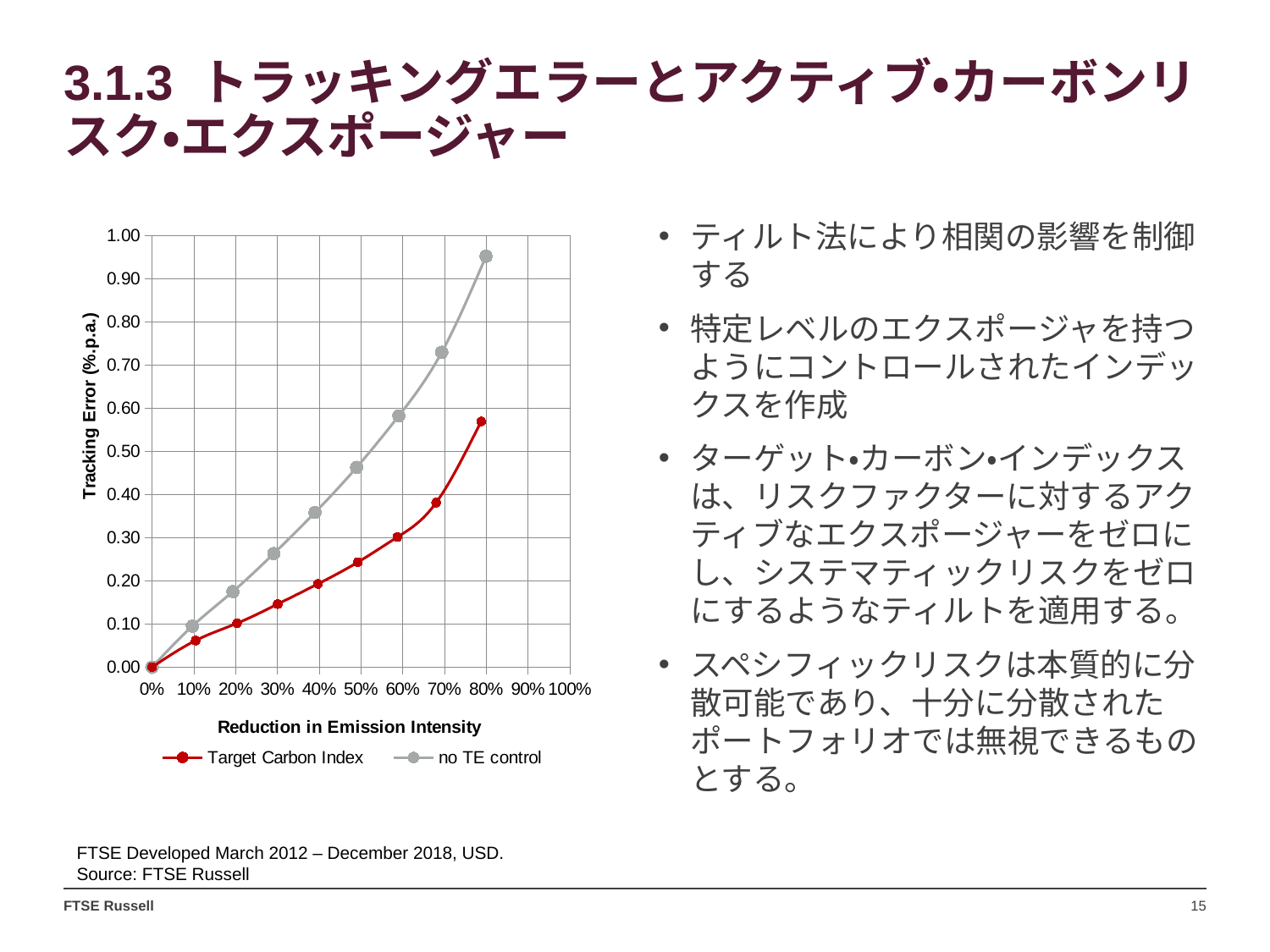
What is the title of the chart's vertical axis? Tracking Error (%.p.a.) What kind of chart is shown on the slide? line chart Is the tracking error for no TE control at an 80% reduction greater or less than 0.90? greater At an 80% reduction in emission intensity, which series has the higher tracking error, Target Carbon Index or no TE control? no TE control Is the tracking error for the Target Carbon Index at a 40% reduction greater or less than 0.30? less Does the tracking error for the Target Carbon Index rise or fall as the reduction in emission intensity increases? rise What is the tracking error for the Target Carbon Index at a 0% reduction in emission intensity? 0.00 How many series does the chart legend list? 2 What are the two series named in the chart legend? Target Carbon Index and no TE control Which series reaches the highest tracking error on the chart? no TE control Is the tracking error for the Target Carbon Index at an 80% reduction greater or less than 0.50? greater